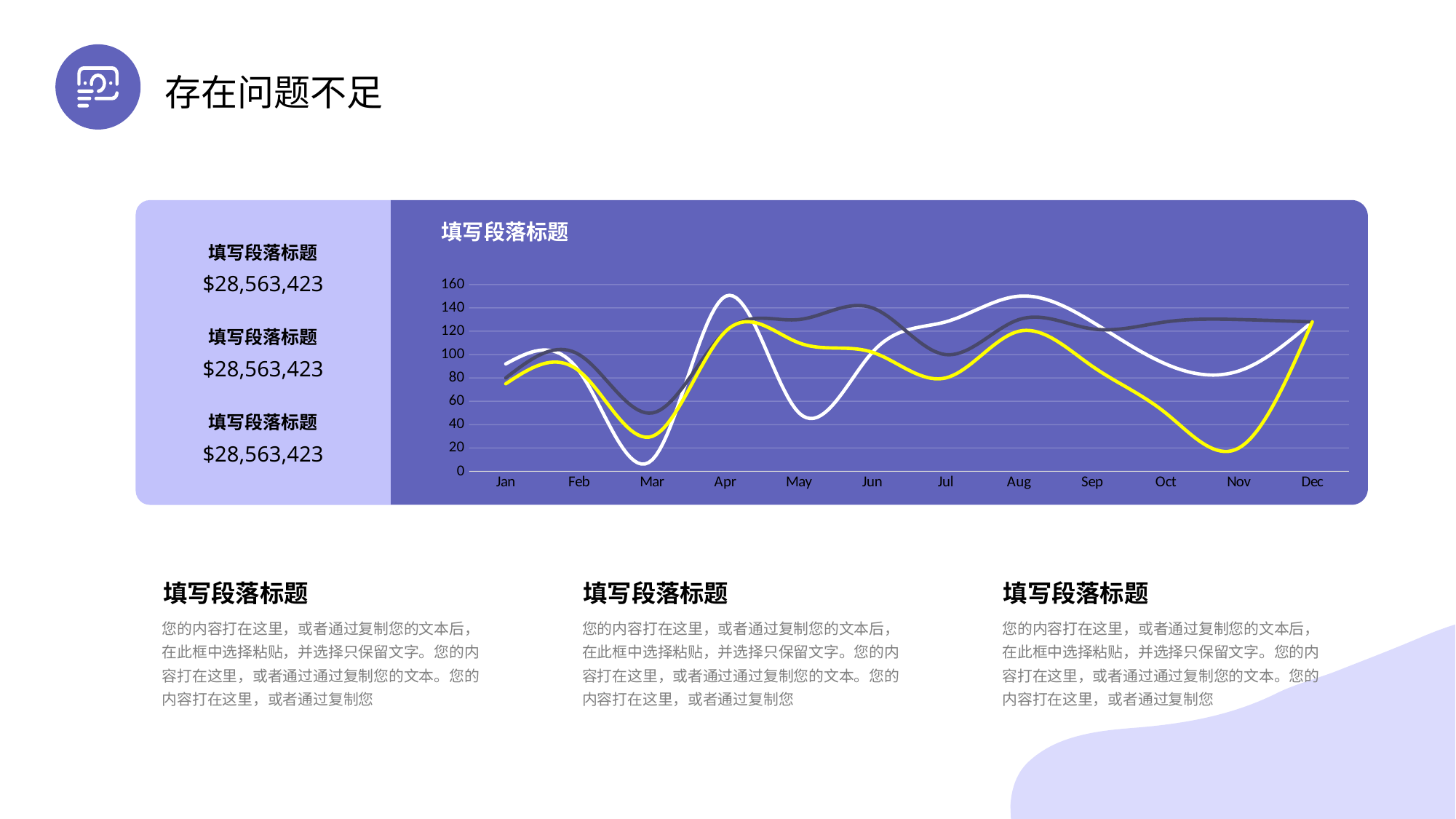
Is the value of the yellow line in Nov greater or less than 40? less Is the value of the dark line in Jun greater or less than 120? greater How many months are shown on the x axis of the chart? 12 Is the value of the white line in Mar greater or less than 20? less Does the white line rise or fall from Apr to May? fall What is the highest value shown on the chart's y axis? 160 In which month does the white line reach its lowest value? Mar What kind of chart is shown on the slide? line chart How many lines are plotted on the chart? 3 In Mar, which line is higher, the white line or the yellow line? the yellow line